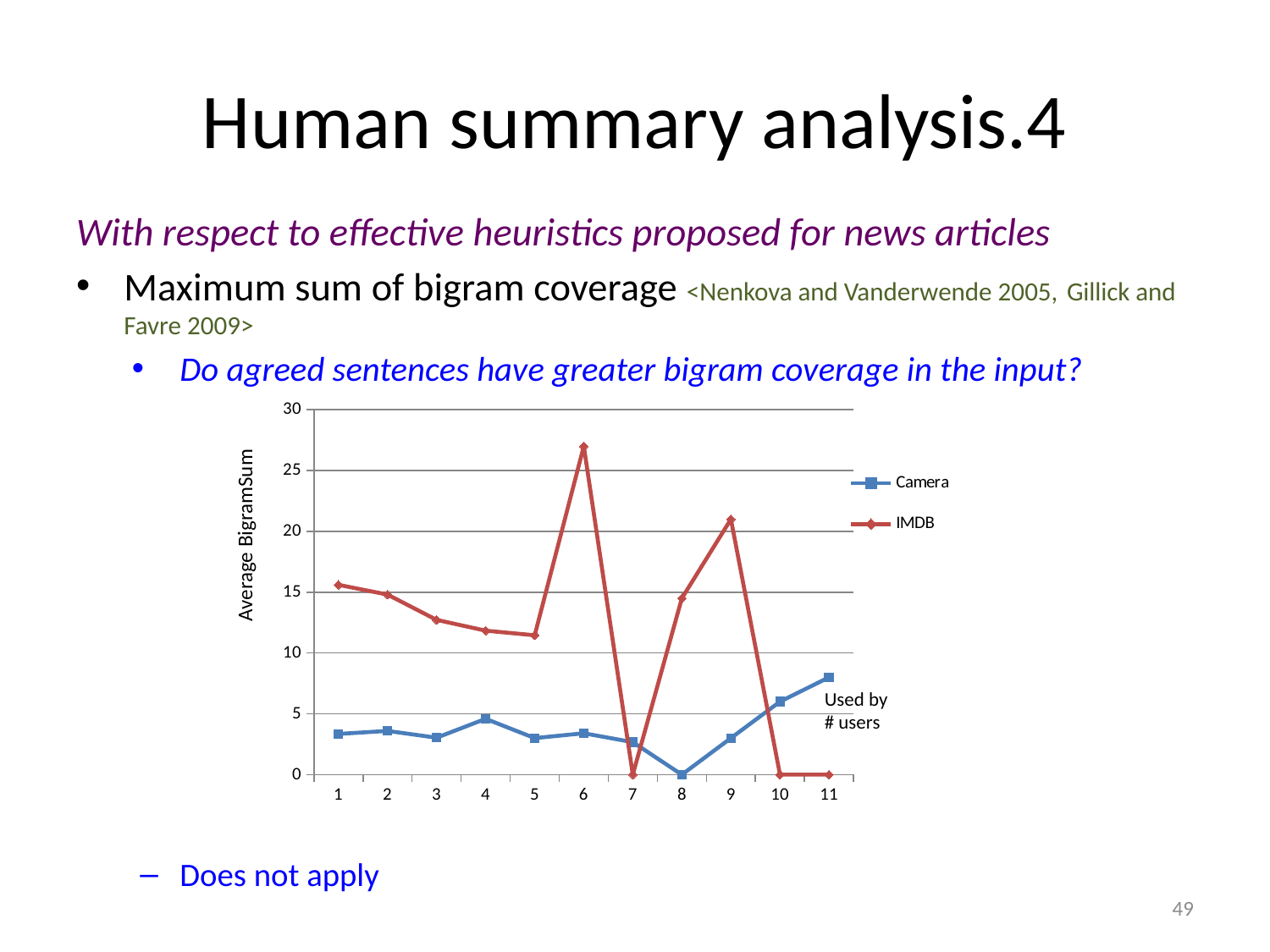
What kind of chart is shown on the slide? line chart How many series does the legend list? 2 Is the IMDB value at x = 6 greater or less than 25? greater Is the Camera value at x = 11 greater or less than 5? greater How many points are plotted along the x axis for each series? 11 What is the IMDB value at x = 7? 0 What is the y-axis title of the chart? Average BigramSum Is the IMDB value at x = 3 greater or less than 15? less At which x value does the IMDB series reach its highest point? 6 At x = 1, which series has the larger value, Camera or IMDB? IMDB At which x value does the Camera series reach its highest point? 11 What are the two series named in the legend? Camera and IMDB